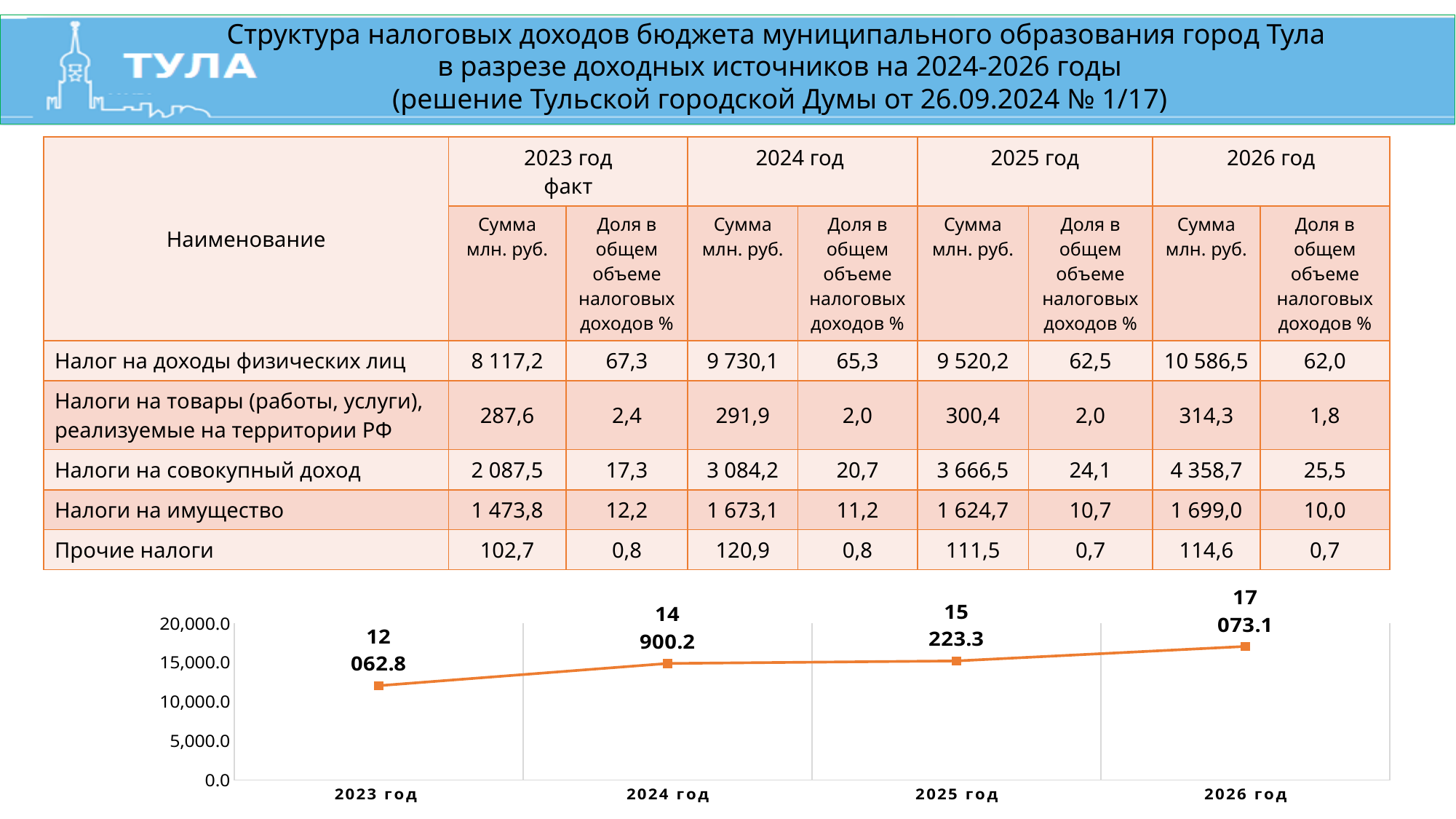
Which year has the highest value on the line chart? 2026 год What is the value plotted for 2025 год on the line chart? 15 223.3 What is the value plotted for 2023 год on the line chart? 12 062.8 How many data points are plotted on the line chart? 4 What type of chart is shown at the bottom of the slide? line chart Do the values on the line chart rise or fall from 2023 год to 2026 год? rise On the line chart, what is the difference between the values for 2026 год and 2023 год? 5 010.3 Which year has the lowest value on the line chart? 2023 год On the line chart, which is larger: the value for 2025 год or the value for 2024 год? 2025 год On the line chart, what is the difference between the values for 2024 год and 2023 год? 2 837.4 What is the value plotted for 2026 год on the line chart? 17 073.1 What is the value plotted for 2024 год on the line chart? 14 900.2